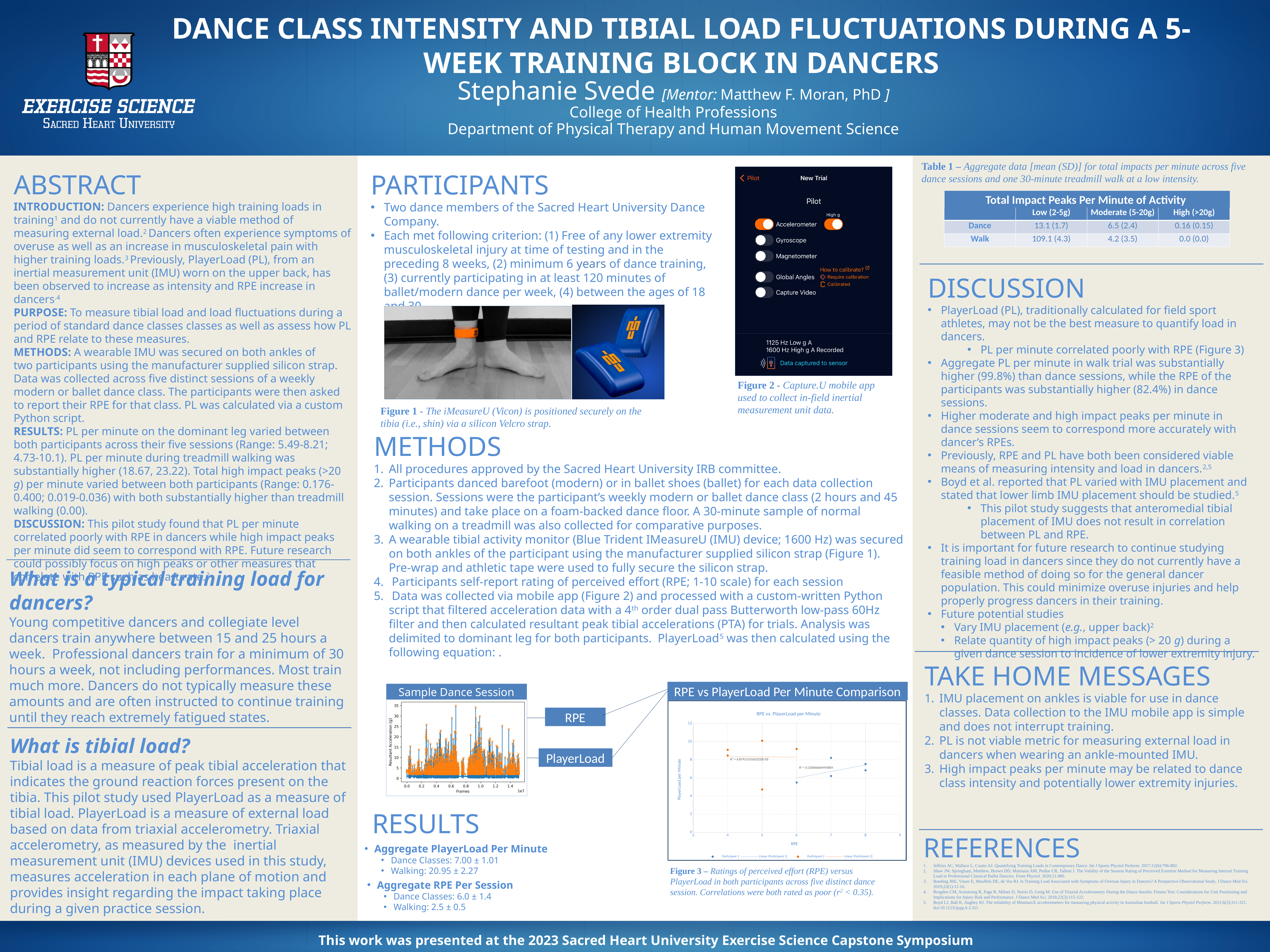
How many linear trend lines are drawn on the 'RPE vs. PlayerLoad per Minute' chart? 2 What is the y-axis label of the 'RPE vs. PlayerLoad per Minute' chart? PlayerLoad per Minute How many entries does the legend of the 'RPE vs. PlayerLoad per Minute' chart list? 4 What is the maximum value shown on the x-axis (RPE) of the 'RPE vs. PlayerLoad per Minute' chart? 9 What is the maximum value shown on the y-axis of the 'RPE vs. PlayerLoad per Minute' chart? 12 In the 'RPE vs. PlayerLoad per Minute' chart, is the highest plotted PlayerLoad per Minute value greater or less than 8? greater What is the maximum value shown on the y-axis of the 'Sample Dance Session' chart? 35 What kind of chart is the 'Sample Dance Session' chart? line chart In the 'RPE vs. PlayerLoad per Minute' chart, is the lowest plotted PlayerLoad per Minute value greater or less than 6? less What is the title of the chart inside the 'RPE vs PlayerLoad Per Minute Comparison' box? RPE vs. PlayerLoad per Minute What kind of chart is the 'RPE vs. PlayerLoad per Minute' chart? scatter chart